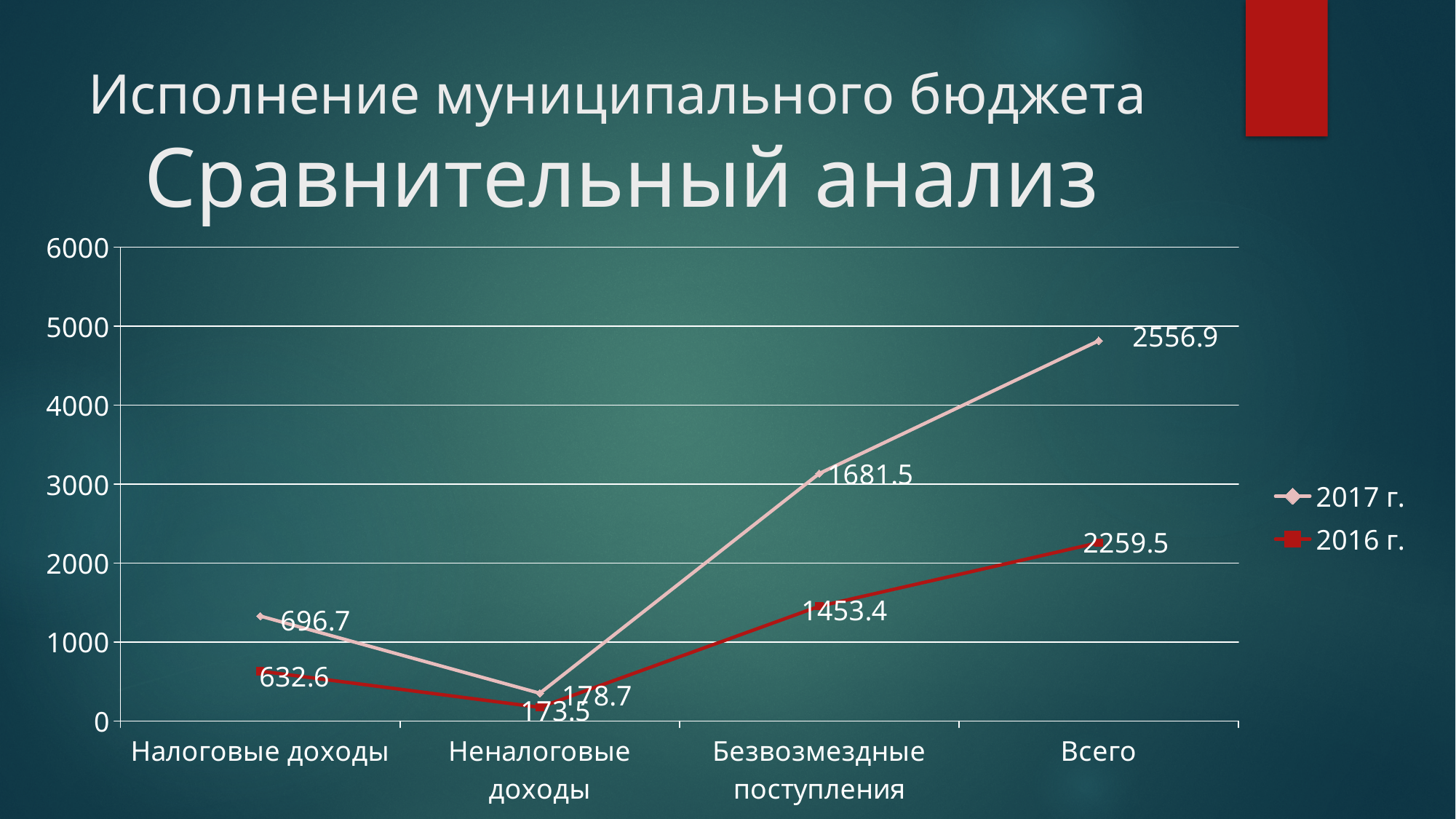
What kind of chart is shown on the slide? line chart What is the difference between the 2017 г. and 2016 г. values for Безвозмездные поступления? 228.1 How many series does the legend list? 2 Which category has the lowest value in the 2017 г. series? Неналоговые доходы What is the value for Неналоговые доходы in the 2016 г. series? 173.5 Which category has the highest value in the 2016 г. series? Всего What is the value for Налоговые доходы in the 2016 г. series? 632.6 What is the value for Безвозмездные поступления in the 2017 г. series? 1681.5 How many categories are shown on the x axis? 4 Which is larger for Налоговые доходы: the 2017 г. value or the 2016 г. value? 2017 г. What is the difference between the 2017 г. and 2016 г. values for Всего? 297.4 What is the value for Всего in the 2017 г. series? 2556.9